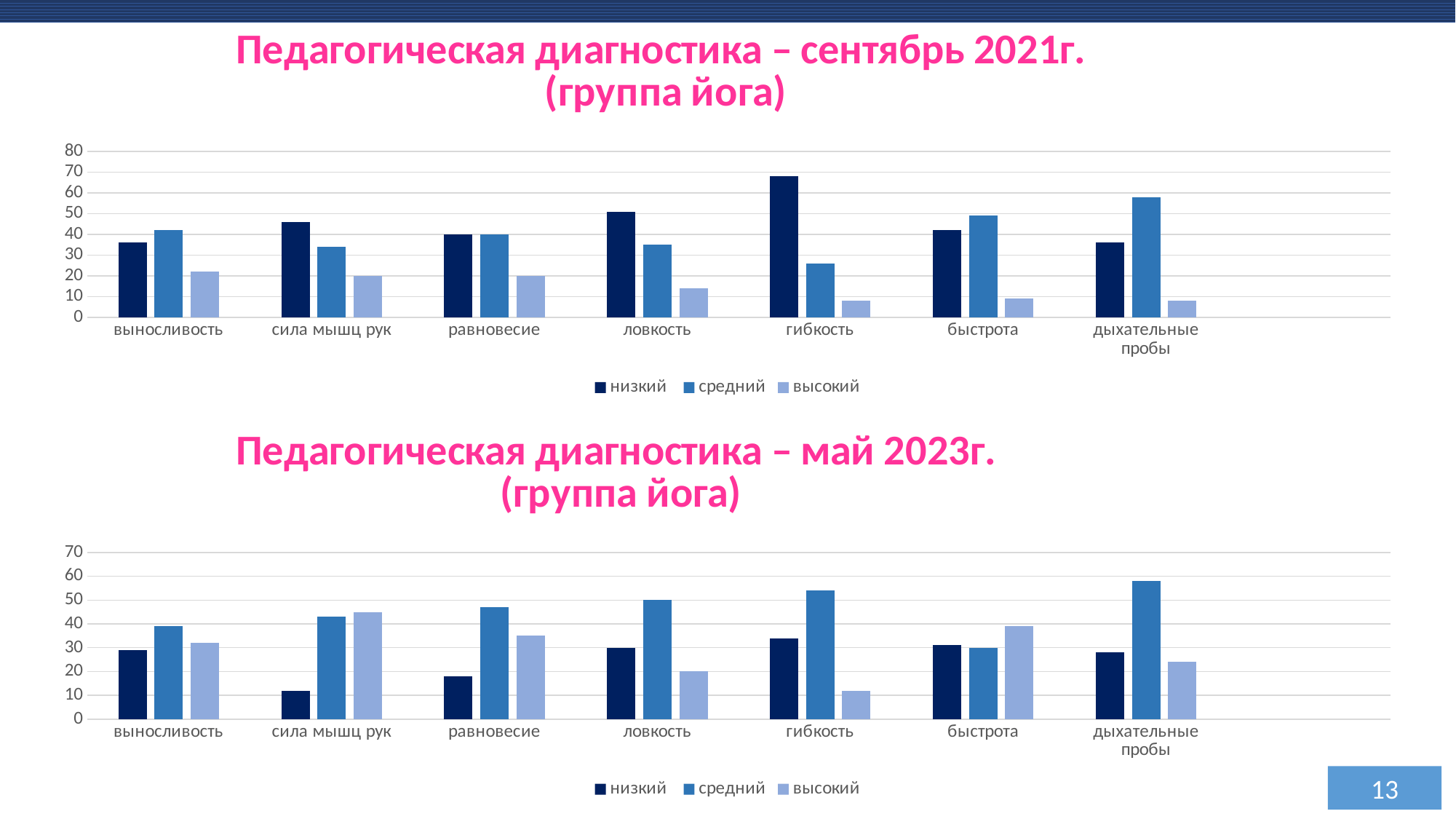
In the top chart (Педагогическая диагностика – сентябрь 2021г.), what kind of chart is shown? bar chart In the bottom chart (май 2023г.), which category has the highest value for the высокий series? сила мышц рук In the top chart (сентябрь 2021г.), which category has the highest value for the низкий series? гибкость In the bottom chart (май 2023г.), is the высокий value for гибкость greater or less than 20? less In the bottom chart (май 2023г.), how many series does the legend list? 3 In the bottom chart (май 2023г.), for равновесие, which is larger: the низкий value or the средний value? средний In the top chart (сентябрь 2021г.), for ловкость, which is larger: the низкий value or the средний value? низкий In the bottom chart (май 2023г.), which category has the lowest value for the низкий series? сила мышц рук In the top chart (сентябрь 2021г.), which category has the highest value for the средний series? дыхательные пробы In the top chart (сентябрь 2021г.), is the низкий value for гибкость greater or less than 60? greater In the top chart (сентябрь 2021г.), is the высокий value for ловкость greater or less than 20? less In the top chart (сентябрь 2021г.), how many categories are shown on the x axis? 7